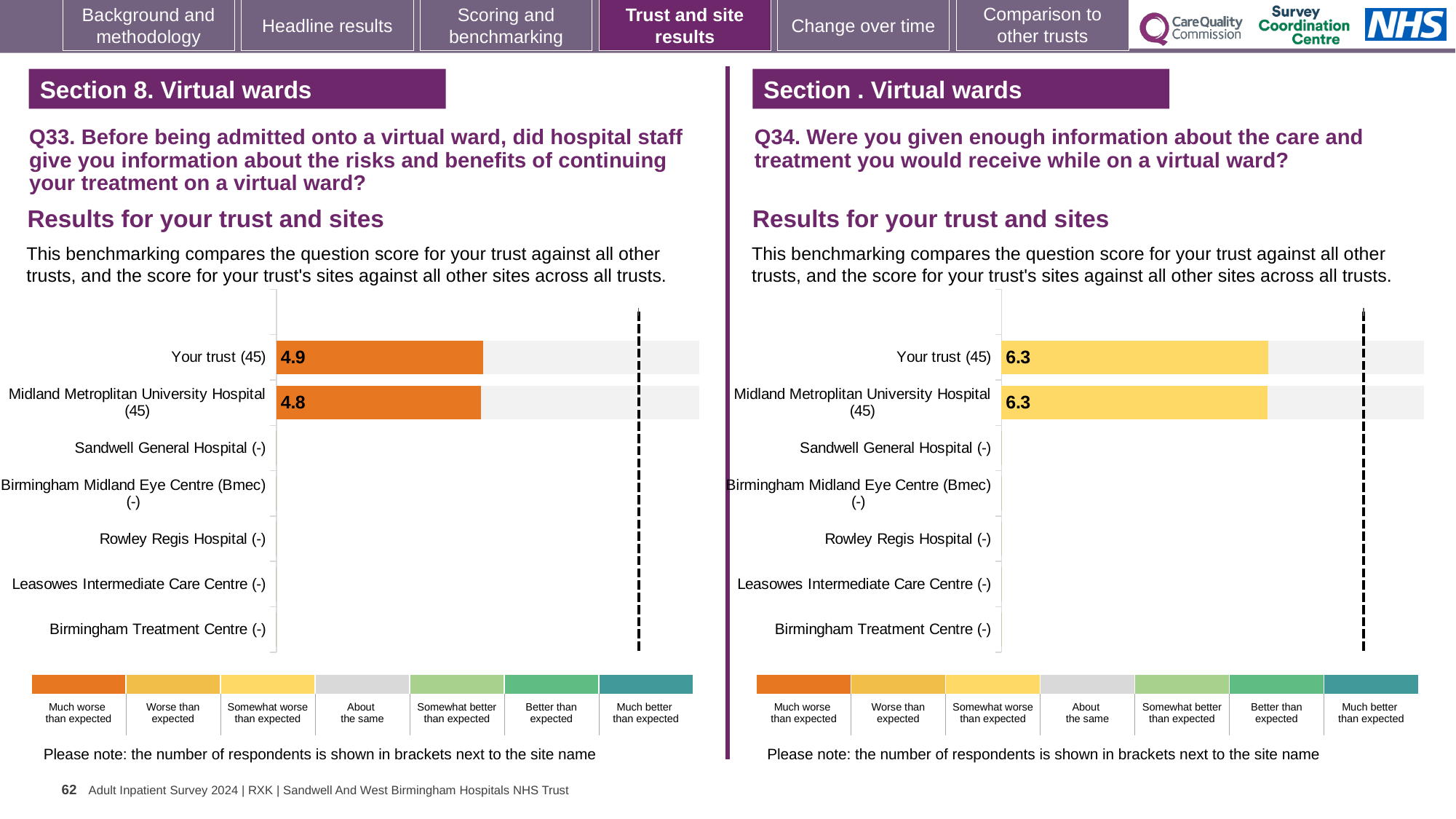
On the Q33 chart (left), how many respondents are shown in brackets for Your trust? 45 How many site/trust categories are listed on the Q33 chart (left)? 7 According to the colour key, which benchmark category does the colour of the bars on the Q34 chart (right) represent? Somewhat worse than expected On the Q34 chart (right), what is the score for Your trust? 6.3 On the Q33 chart (left), what is the score for Midland Metroplitan University Hospital? 4.8 On the Q33 chart (left), which has the higher score: Your trust or Midland Metroplitan University Hospital? Your trust On the Q34 chart (right), how many categories have a plotted bar? 2 On the Q34 chart (right), what is the difference between the score for Your trust and the score for Midland Metroplitan University Hospital? 0 On the Q33 chart (left), what is the score for Your trust? 4.9 What type of chart is used for the Q33 results (left)? Bar chart On the Q33 chart (left), what is the difference between the score for Your trust and the score for Midland Metroplitan University Hospital? 0.1 On the Q34 chart (right), what is the score for Midland Metroplitan University Hospital? 6.3